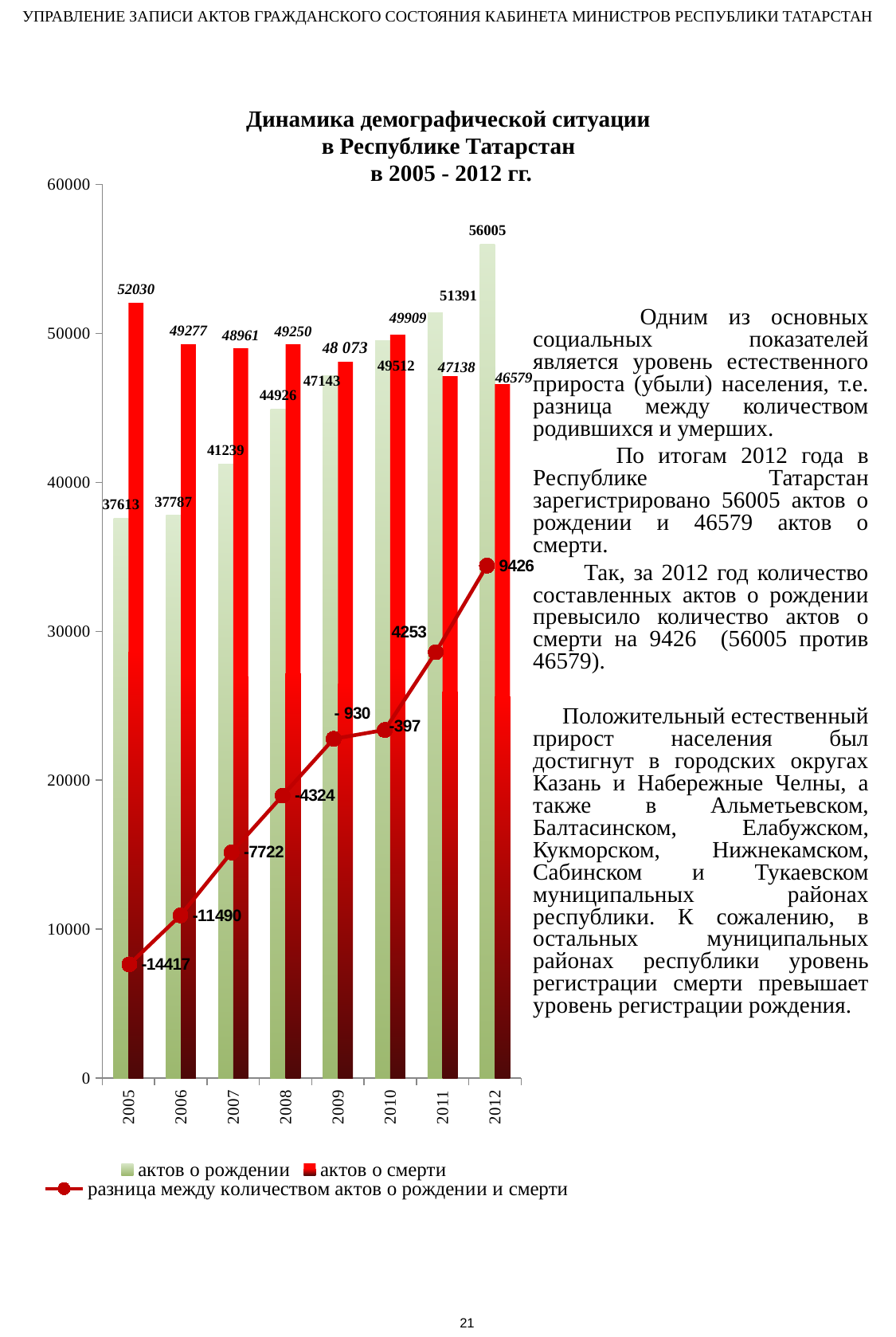
In which year were the fewest death acts registered? 2012 How many series does the legend list? 3 How many years are shown on the x axis? 8 In which year were the most birth acts registered? 2012 Which was larger in 2010: the number of birth acts or the number of death acts? death acts (актов о смерти) What is the difference between the number of birth acts in 2012 and in 2005? 18392 What kind of chart is this? combined bar and line chart How many death acts (актов о смерти) were registered in 2005? 52030 What is the value of the difference line (разница между количеством актов о рождении и смерти) for 2008? -4324 In which year were the fewest birth acts registered? 2005 How many birth acts (актов о рождении) were registered in 2012? 56005 Do the birth act values rise or fall from 2005 to 2012? rise